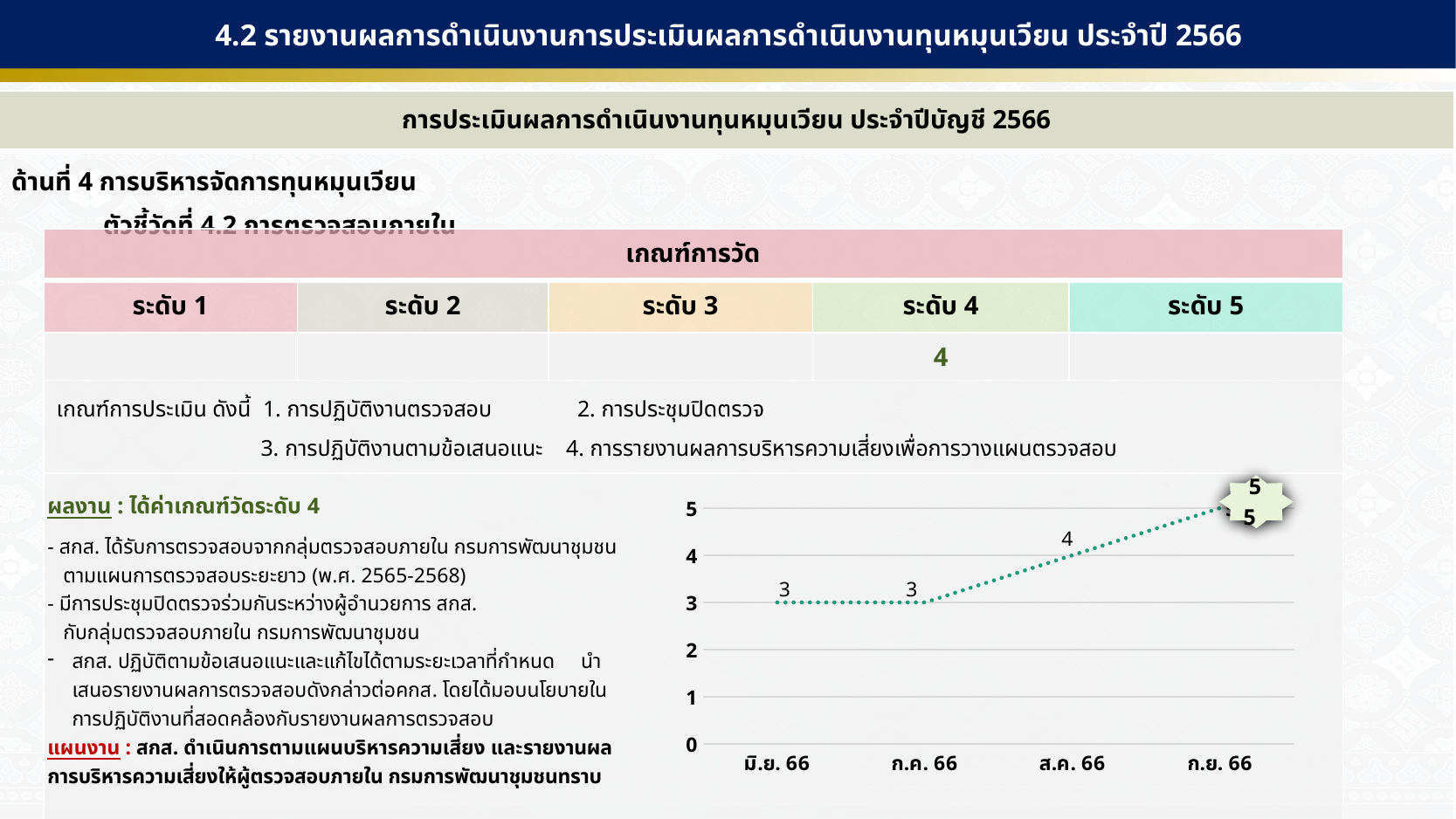
Do the values rise or fall from มิ.ย. 66 to ก.ย. 66? rise Which is larger, the value for ส.ค. 66 or the value for ก.ค. 66? ส.ค. 66 What kind of chart is shown on the slide? line chart What is the difference between the values for ส.ค. 66 and ก.ค. 66? 1 Which month has the highest value in the chart? ก.ย. 66 What is the difference between the values for ก.ย. 66 and มิ.ย. 66? 2 What is the value for ก.ย. 66 in the chart? 5 What is the value for มิ.ย. 66 in the chart? 3 Is the value for ก.ย. 66 greater or less than 4? greater What is the value for ส.ค. 66 in the chart? 4 What is the value for ก.ค. 66 in the chart? 3 How many data points are plotted in the chart? 4